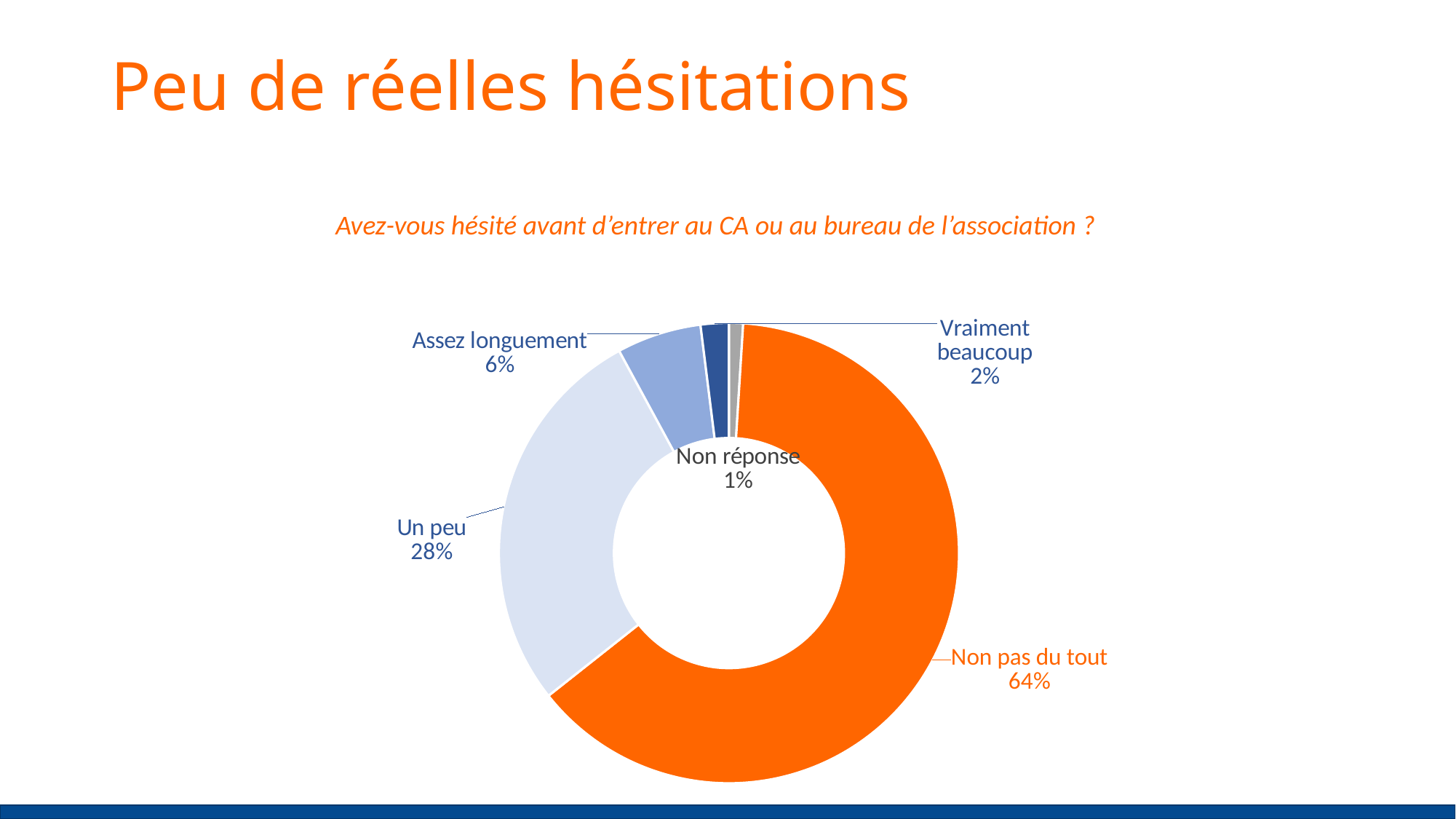
What question does the chart's subtitle say respondents were asked? Avez-vous hésité avant d'entrer au CA ou au bureau de l'association ? What percentage of respondents answered "Vraiment beaucoup"? 2% How many response categories are shown in the chart? 5 What is the difference in percentage points between "Non pas du tout" and "Un peu"? 36 Which response category has the largest share of the chart? Non pas du tout What type of chart is shown on the slide? Doughnut (pie) chart Which response category has the smallest share of the chart? Non réponse What percentage of respondents answered "Un peu"? 28% What share is labelled "Non réponse"? 1% What percentage of respondents answered "Assez longuement"? 6% Which is larger: the share for "Assez longuement" or the share for "Vraiment beaucoup"? Assez longuement What percentage of respondents answered "Non pas du tout"? 64%